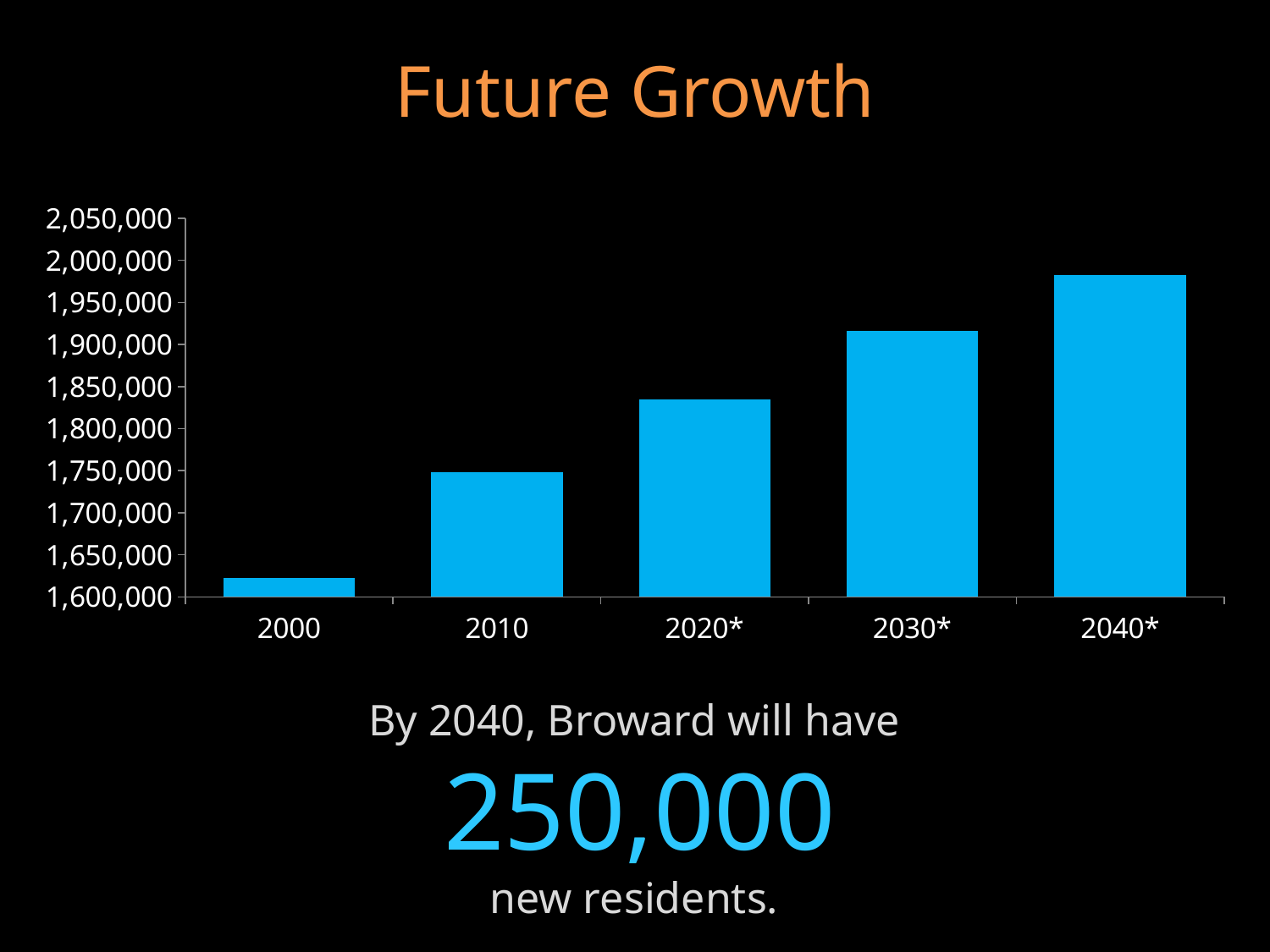
Which year has the highest bar in the chart? 2040* What is the title of the slide containing the chart? Future Growth Is the value for 2020* greater or less than 1,800,000? greater Is the value for 2000 greater or less than 1,650,000? less Is the value for 2040* greater or less than 2,000,000? less Do the values rise or fall from 2000 to 2040* along the x axis? rise How many bars (categories) are plotted in the chart? 5 Which is larger, the value for 2010 or the value for 2030*? 2030* What kind of chart is shown on the slide? bar chart Which year has the lowest bar in the chart? 2000